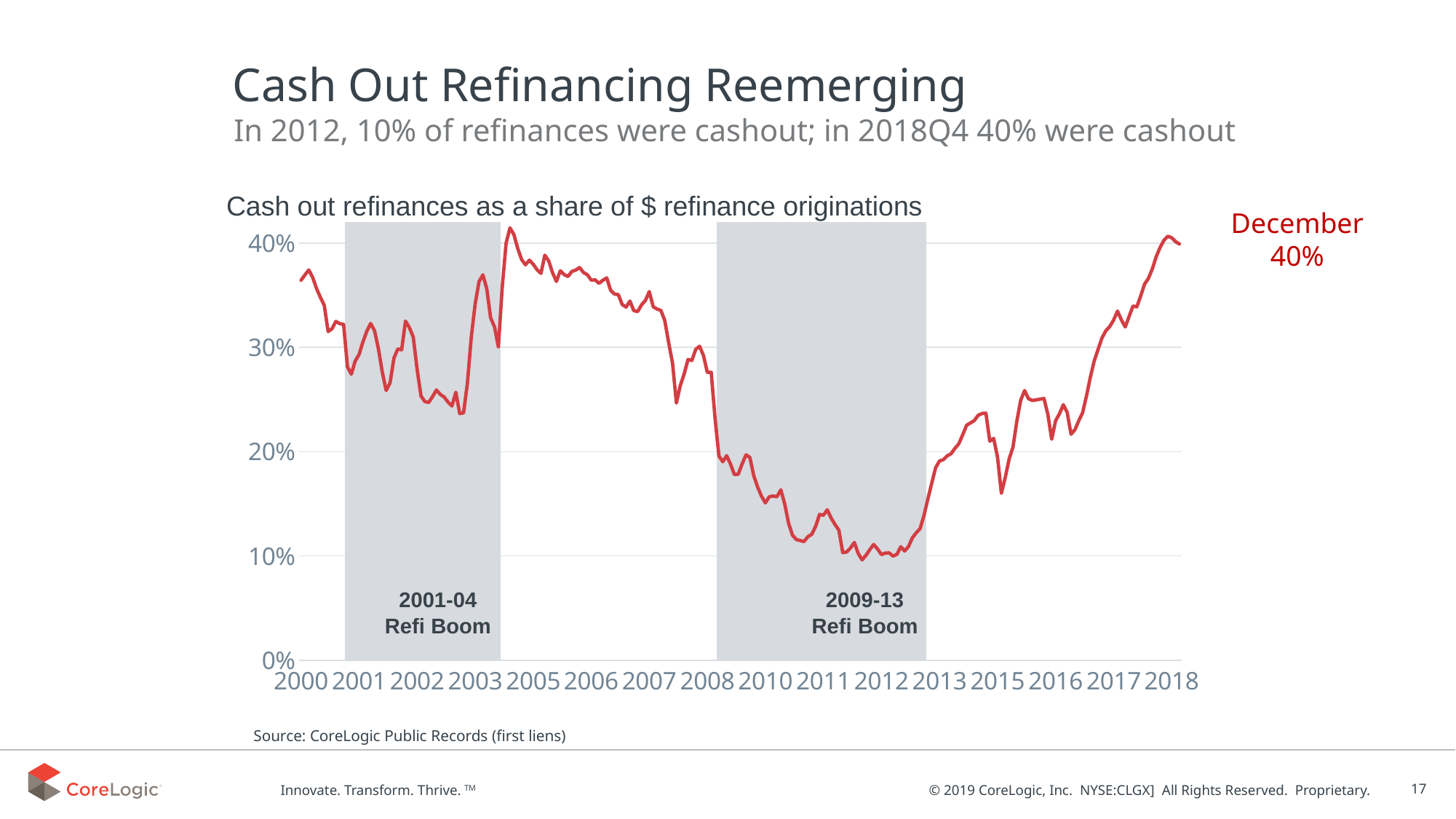
Is the cash out refinance share in 2015 greater or less than 30%? less What kind of chart is shown on the slide? line chart Is the cash out refinance share at the start of 2000 greater or less than 30%? greater What are the two shaded periods on the chart labelled? 2001-04 Refi Boom and 2009-13 Refi Boom Does the cash out refinance share rise or fall between 2008 and 2012? fall Is the cash out refinance share in 2012 greater or less than 20%? less What is the cash out refinance share labelled for December at the end of the line? 40% According to the slide, what share of refinances were cashout in 2012? 10% Does the cash out refinance share rise or fall between 2013 and 2018? rise In which year does the line reach its lowest point? 2012 Which is larger, the cash out refinance share in 2005 or in 2012? 2005